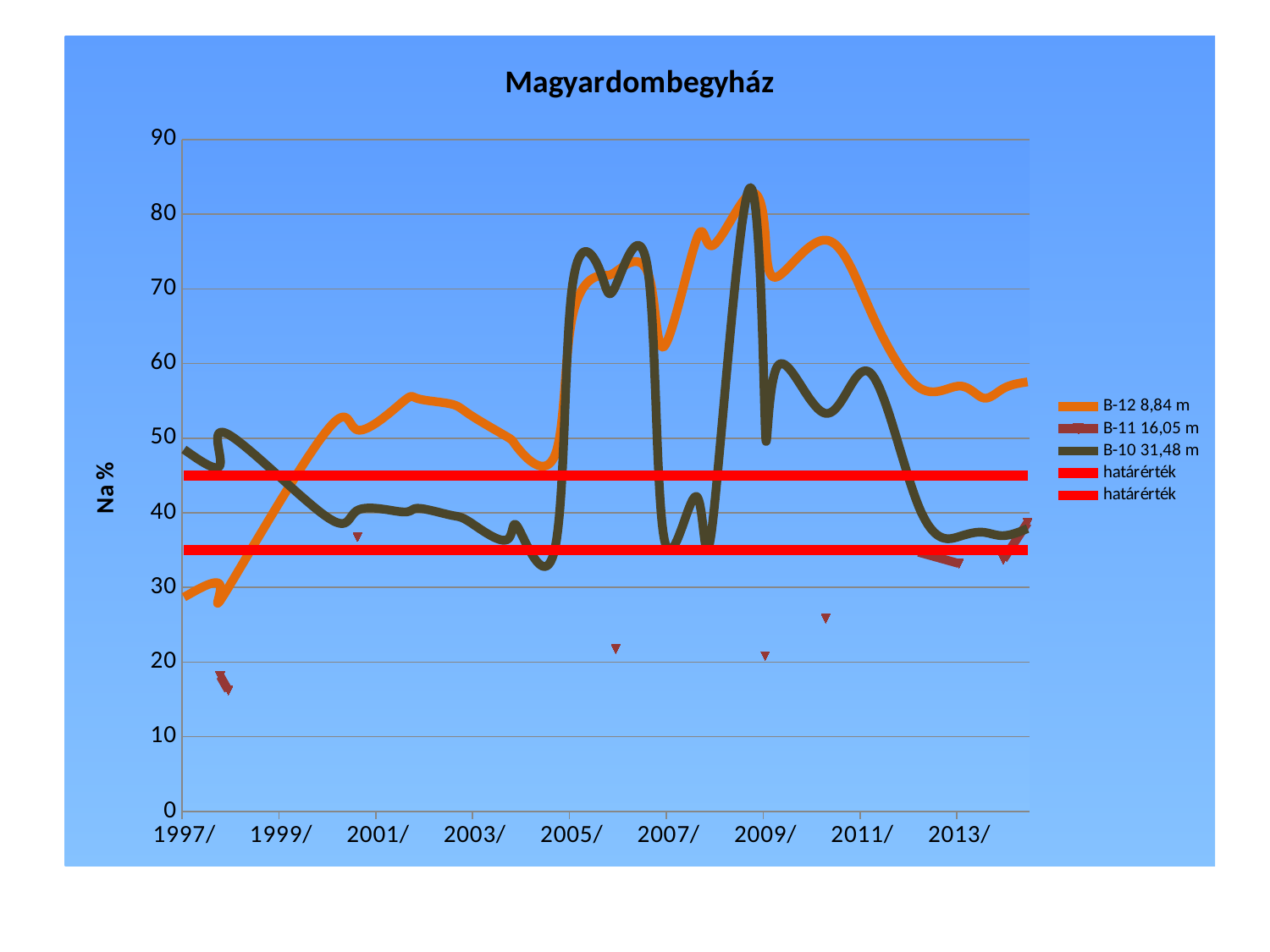
Is the value for B-10 31,48 m at 1997/ greater or less than 40? greater Is the upper határérték line greater or less than 40? greater Is the value for B-12 8,84 m at 1997/ greater or less than 40? less How many series does the legend list? 5 Does the B-12 8,84 m line rise or fall between 1997/ and 2001/? rise What is the title of the chart? Magyardombegyház What kind of chart is shown on the slide? line chart What is the label of the vertical axis? Na %